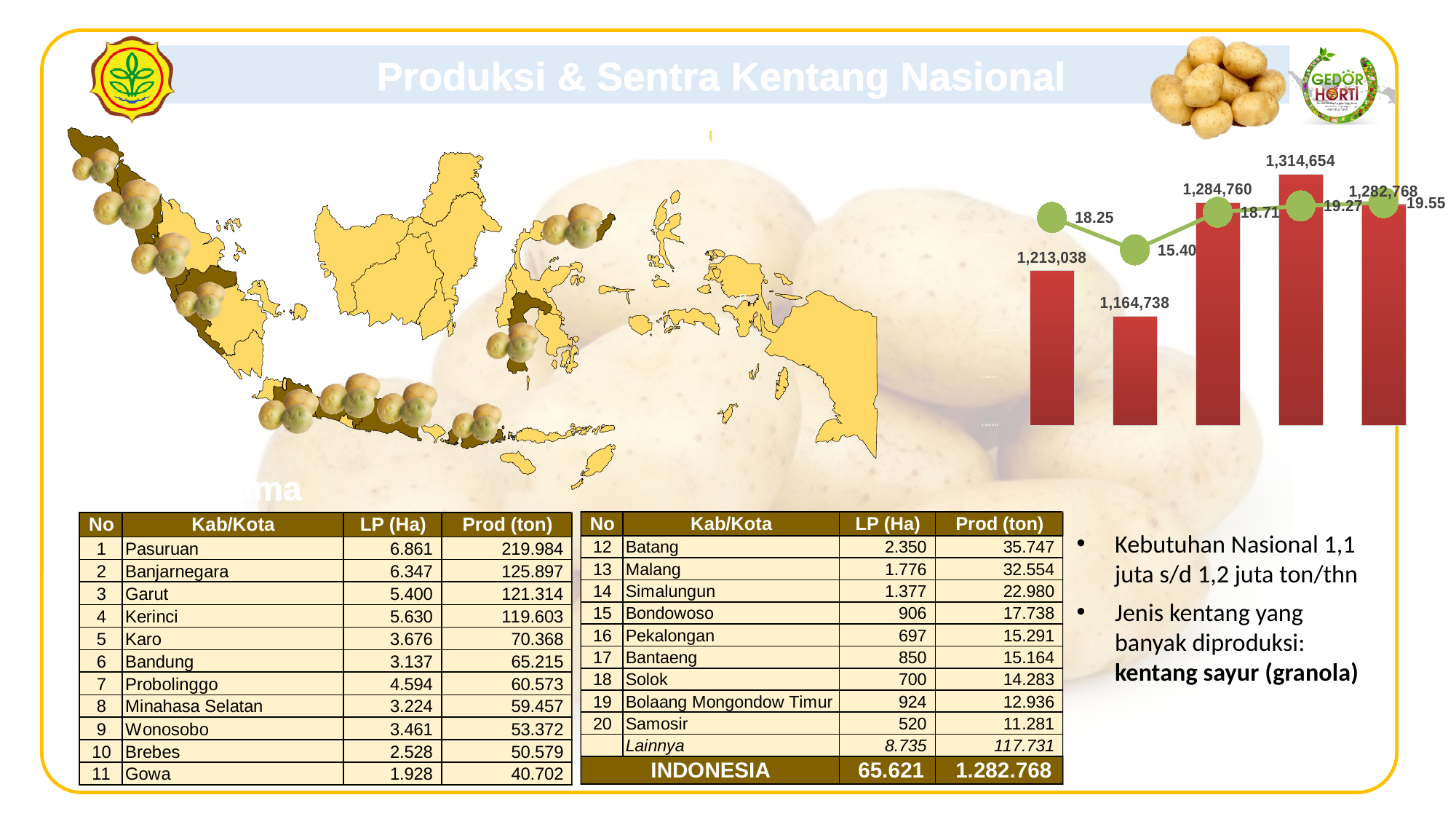
From the second point onward, do the values on the green line rise or fall? Rise What is the difference between the fourth bar (1,314,654) and the first bar (1,213,038) in the chart? 101,616 What is the highest value labelled on the green line in the chart? 19.55 Which red bar in the chart has the lowest value? The second bar (1,164,738) What is the value labelled on the second red bar of the chart? 1,164,738 How many red bars are plotted in the chart? 5 What is the value labelled on the second point of the green line in the chart? 15.40 Is the value of the first red bar larger or smaller than the value of the third red bar? Smaller What is the value labelled on the first (leftmost) red bar of the chart? 1,213,038 What is the value labelled on the last (rightmost) red bar of the chart? 1,282,768 Which red bar in the chart has the highest value? The fourth bar (1,314,654) What is the value labelled on the fourth red bar of the chart? 1,314,654